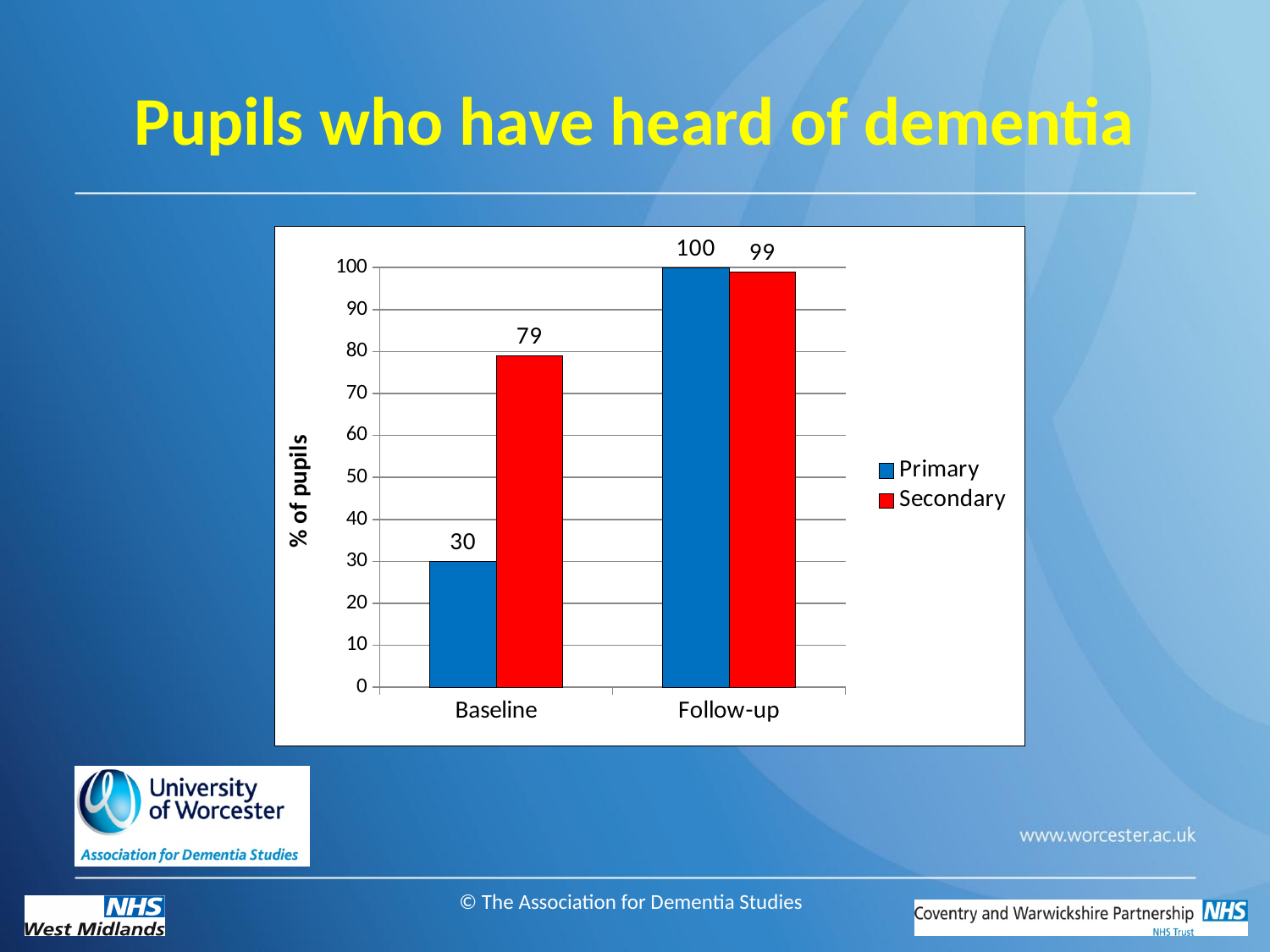
How many series does the legend list? 2 At Baseline, which is larger: Primary or Secondary? Secondary What is the value for Secondary at Follow-up? 99 Which bar has the lowest value on the chart? Primary at Baseline How many categories are shown on the x axis? 2 What is the value for Primary at Follow-up? 100 By how much did the Primary value increase from Baseline to Follow-up? 70 What is the difference between the Secondary and Primary values at Baseline? 49 Which bar has the highest value on the chart? Primary at Follow-up What is the value for Primary at Baseline? 30 What kind of chart is shown on the slide? Bar chart What is the value for Secondary at Baseline? 79